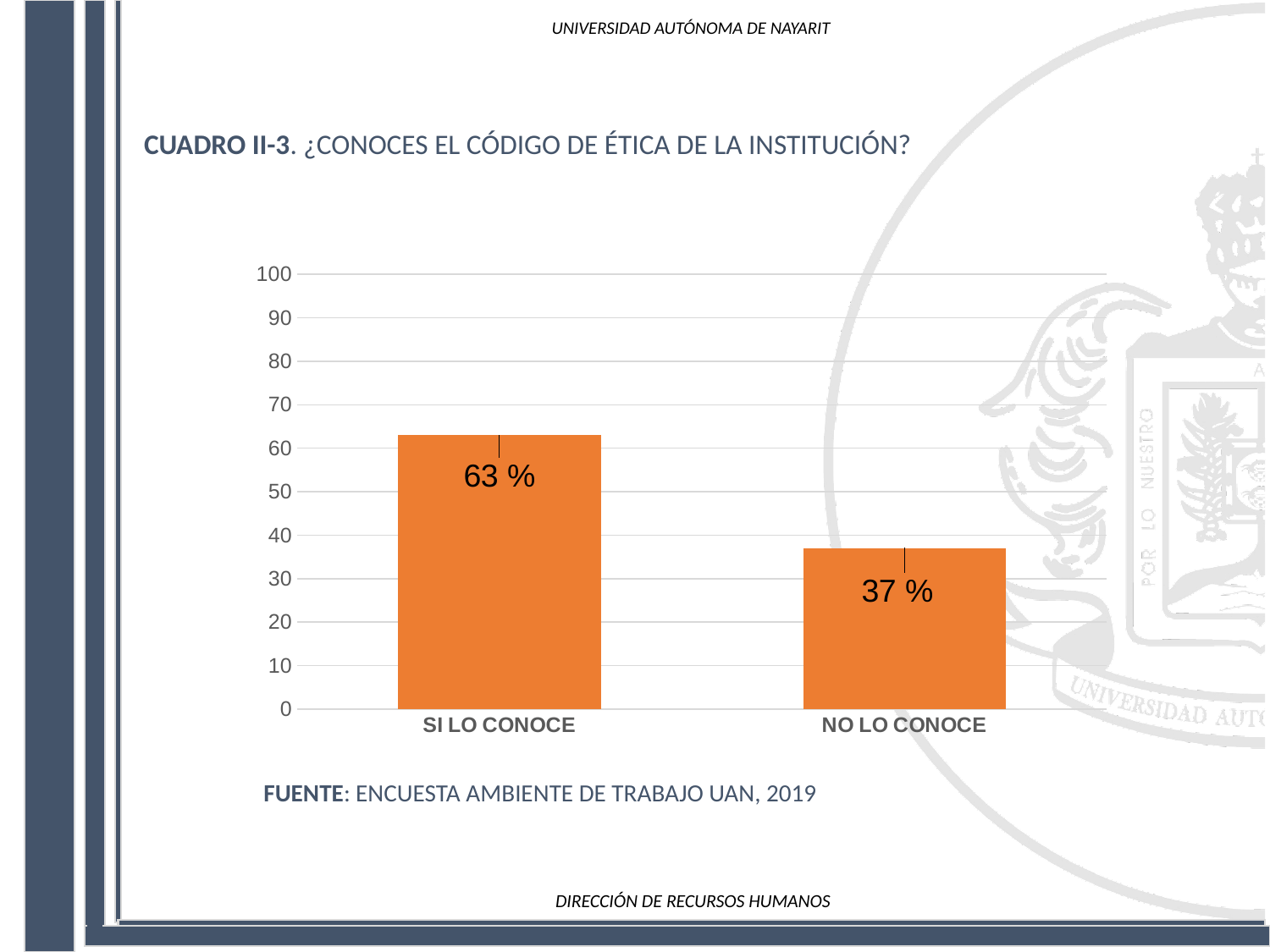
How many categories are shown on the x axis? 2 What is the total of the two bar values? 100 % What is the difference between the values for SI LO CONOCE and NO LO CONOCE? 26 % Which category has the lowest value? NO LO CONOCE What kind of chart is shown on the slide? bar chart What is the source cited below the chart? ENCUESTA AMBIENTE DE TRABAJO UAN, 2019 What is the value for SI LO CONOCE? 63 % Which is larger, the value for SI LO CONOCE or NO LO CONOCE? SI LO CONOCE Which category has the highest value? SI LO CONOCE What is the value for NO LO CONOCE? 37 % Is the value for NO LO CONOCE greater or less than 40? less Is the value for SI LO CONOCE greater or less than 60? greater